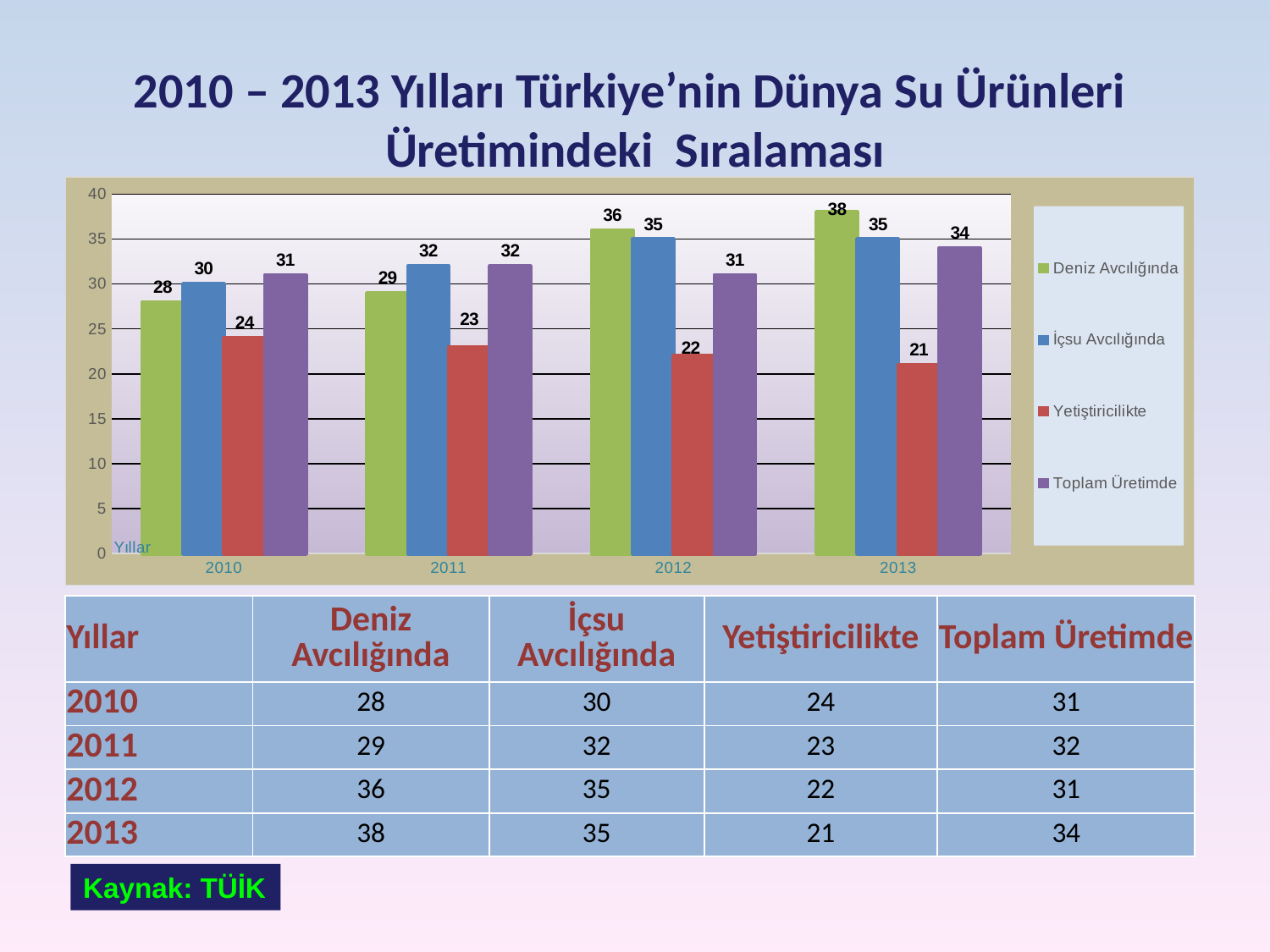
Does the Deniz Avcılığında value rise or fall from 2010 to 2013? rise What is the difference between the Deniz Avcılığında values for 2013 and 2010? 10 How many years are shown on the x axis? 4 In which year is the Deniz Avcılığında value highest? 2013 Is the value for Yetiştiricilikte in 2012 greater or less than 25? less What is the value for Yetiştiricilikte in 2010? 24 Which is larger in 2011: İçsu Avcılığında or Deniz Avcılığında? İçsu Avcılığında What is the value for Deniz Avcılığında in 2012? 36 What kind of chart is shown? bar chart How many series does the legend list? 4 In which year is the Yetiştiricilikte value lowest? 2013 What is the value for Toplam Üretimde in 2013? 34